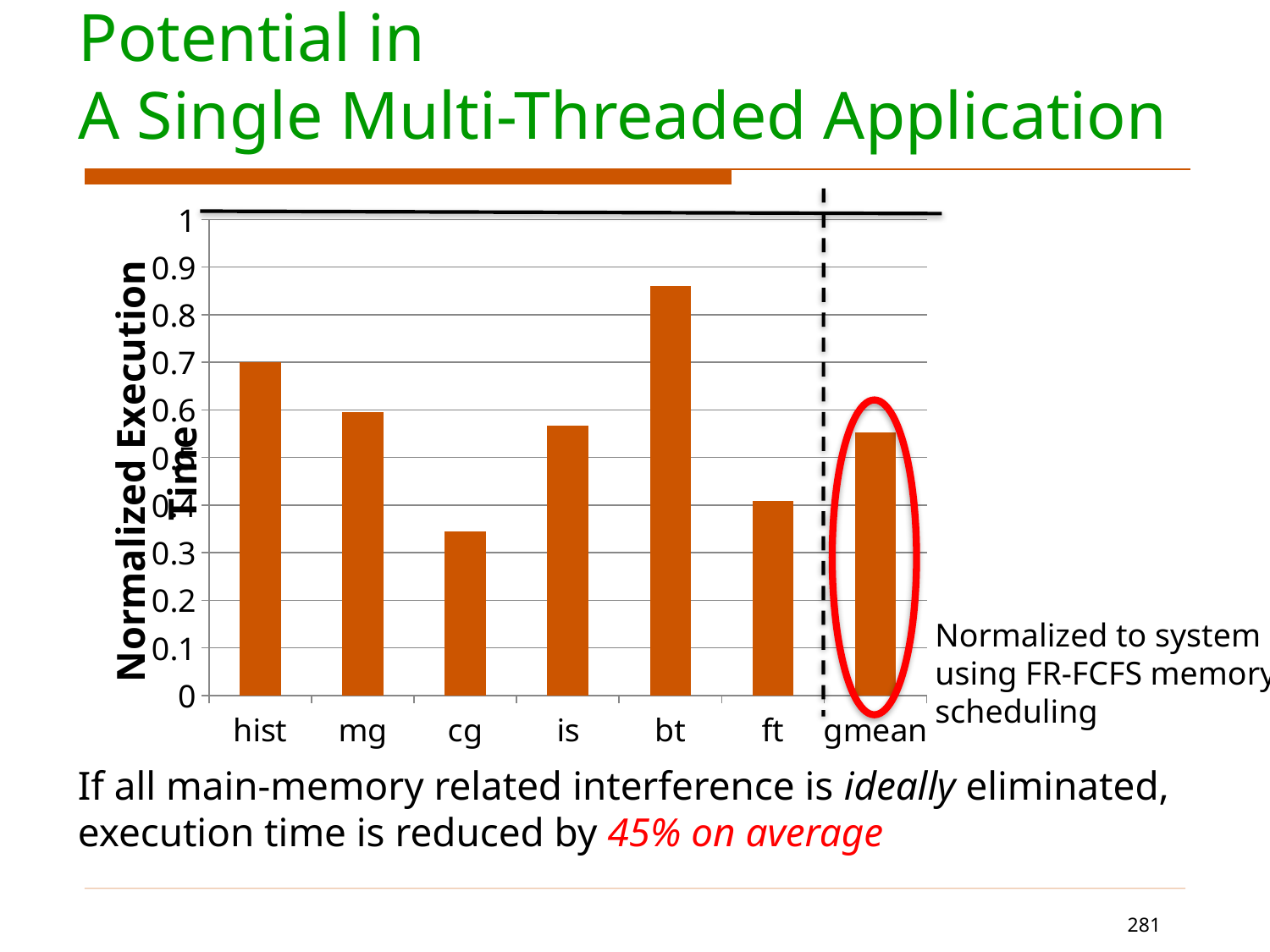
Is the value for bt greater or less than 0.8? greater Is the value for cg greater or less than 0.4? less Is the value for ft greater or less than 0.5? less Which has a lower normalized execution time, ft or is? ft Which category has the highest normalized execution time? bt How many categories are plotted along the x axis? 7 Which category has the lowest normalized execution time? cg What is the label of the y axis? Normalized Execution Time What kind of chart is shown on the slide? bar chart Which category is circled in red on the chart? gmean Which has a higher normalized execution time, hist or mg? hist